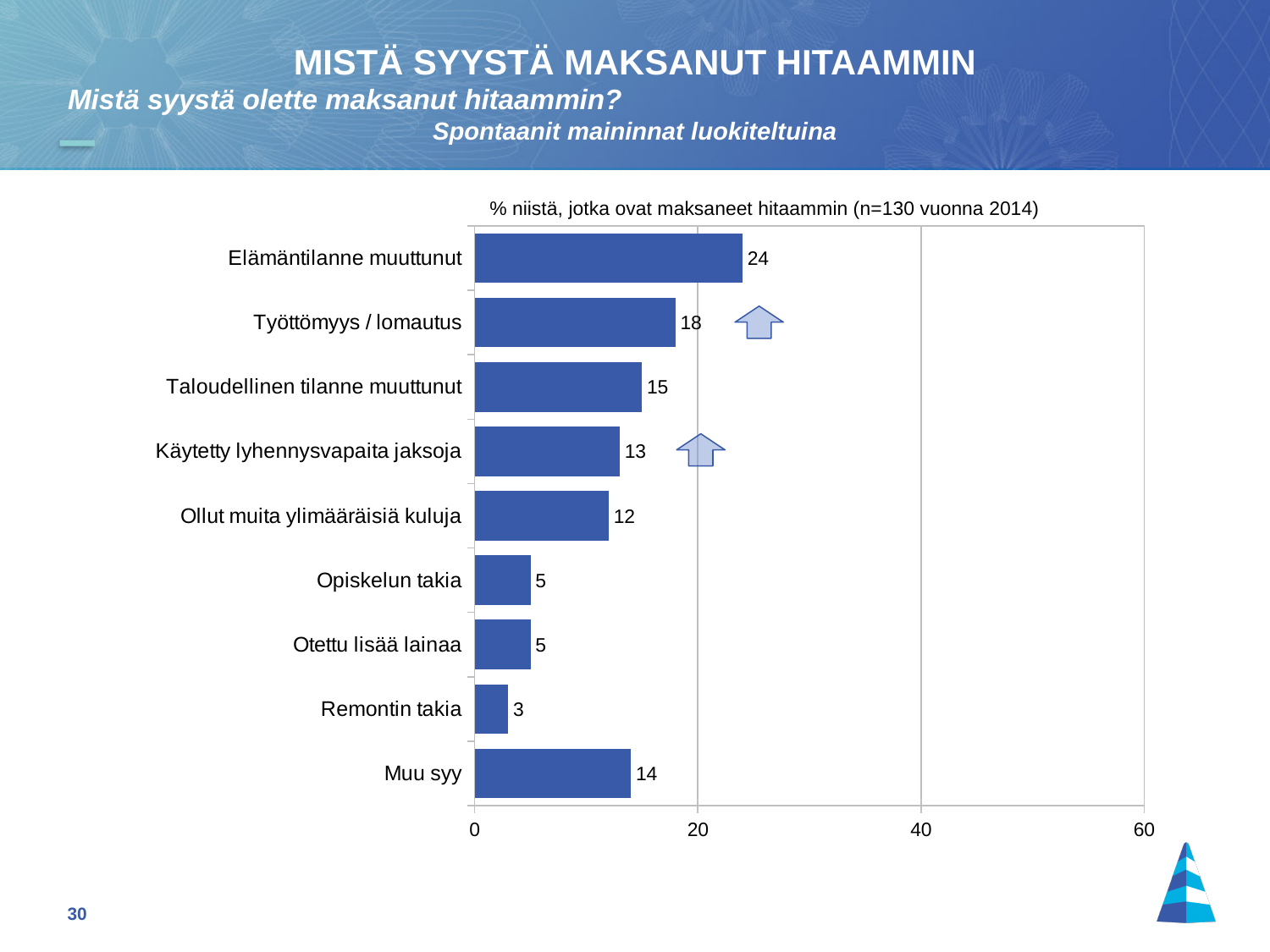
How many categories are shown in the chart? 9 Which is larger, the value for Ollut muita ylimääräisiä kuluja or the value for Muu syy? Muu syy Which category has the lowest value? Remontin takia What is the value for Käytetty lyhennysvapaita jaksoja? 13 Which category has the highest value? Elämäntilanne muuttunut What is the sample size (n) stated in the chart's subtitle? n=130 What is the value for Elämäntilanne muuttunut? 24 Is the value for Elämäntilanne muuttunut greater or less than 20? greater What kind of chart is shown on the slide? bar chart What is the value for Työttömyys / lomautus? 18 What is the value for Muu syy? 14 What is the difference between the values for Elämäntilanne muuttunut and Taloudellinen tilanne muuttunut? 9